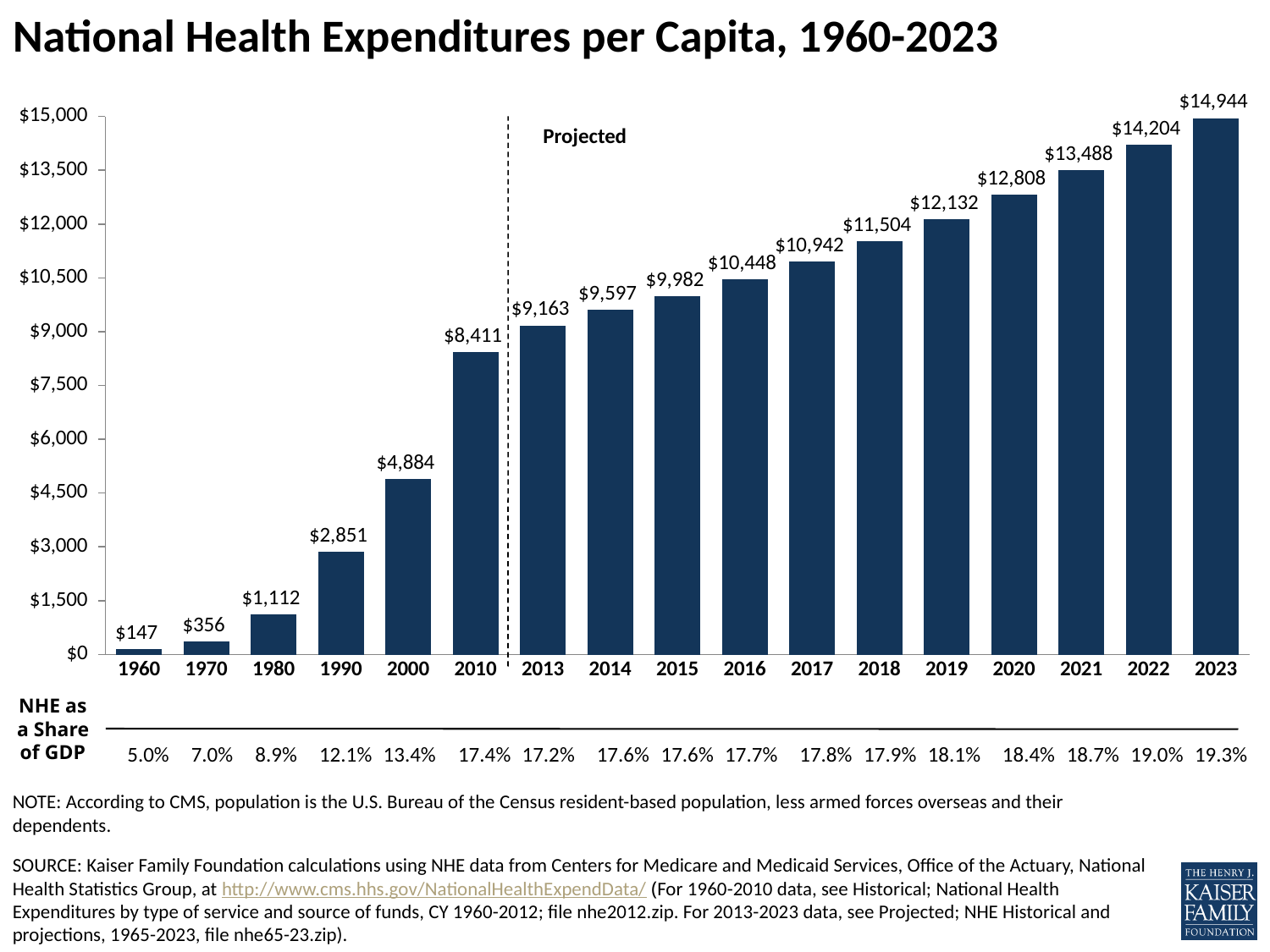
What is the difference between the values for 2000 and 1990? $2,033 How many years (bars) are shown in the chart? 17 Which year has the highest national health expenditure per capita? 2023 What is the value shown for 1960? $147 Which year has the lowest national health expenditure per capita? 1960 What kind of chart is shown on the slide? Bar chart What is the projected national health expenditure per capita for 2023? $14,944 What is the difference between the values for 2023 and 2010? $6,533 Do the values rise or fall from 1960 to 2023? Rise What is the national health expenditure per capita shown for 2010? $8,411 Which is larger, the value for 1980 or the value for 1990? 1990 What is the value shown for 2017? $10,942